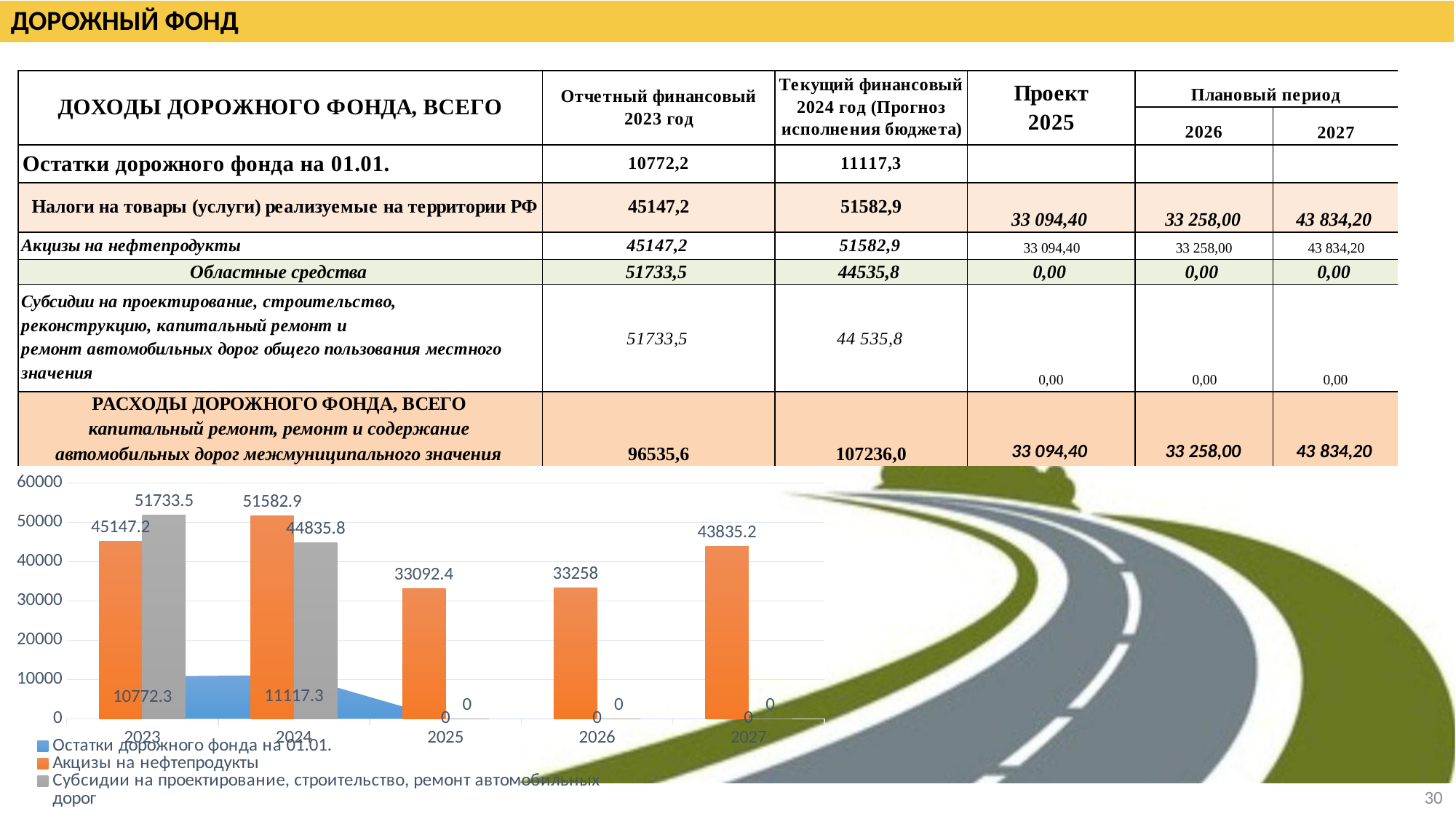
In the chart, what is the value of Субсидии на проектирование, строительство, ремонт автомобильных дорог for 2023? 51733.5 In the chart, what is the value of Остатки дорожного фонда на 01.01. for 2024? 11117.3 How many years are shown on the x axis of the chart? 5 In the chart, what colour represents Акцизы на нефтепродукты? orange In the chart, which year has the highest value for Акцизы на нефтепродукты? 2024 In the chart, for 2023, which is larger: Акцизы на нефтепродукты or Субсидии на проектирование, строительство, ремонт автомобильных дорог? Субсидии на проектирование, строительство, ремонт автомобильных дорог In the chart, what is the value of Акцизы на нефтепродукты for 2024? 51582.9 In the chart, do the values for Акцизы на нефтепродукты rise or fall from 2025 to 2027? rise In the chart, which year has the lowest value for Акцизы на нефтепродукты? 2025 In the chart, what is the difference between the Акцизы на нефтепродукты values for 2027 and 2026? 10577.2 How many series does the chart legend list? 3 In the chart, what is the value of Субсидии на проектирование, строительство, ремонт автомобильных дорог for 2026? 0